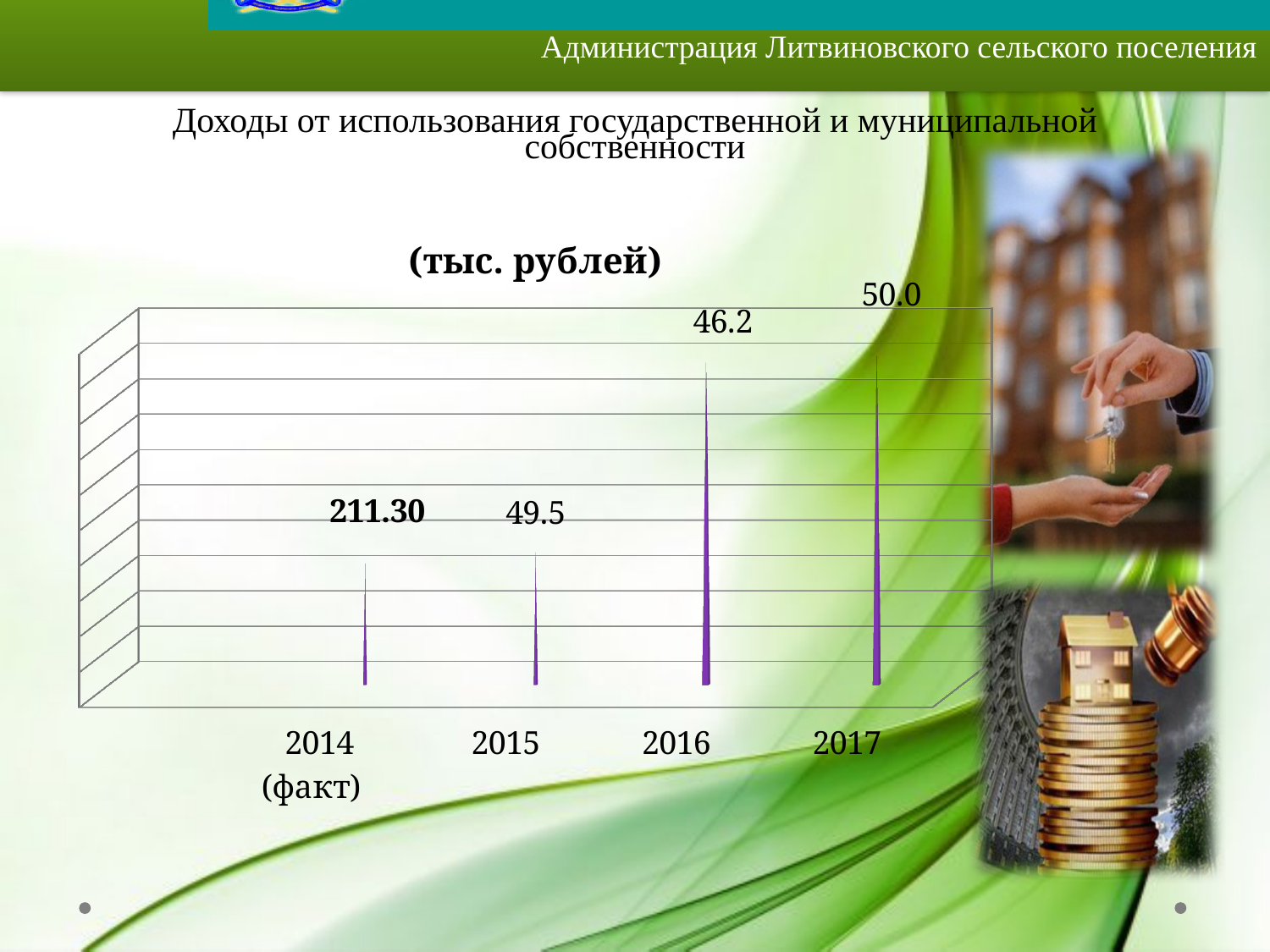
What is the value for 2016? 46.2 What is the title of the slide above the chart? Доходы от использования государственной и муниципальной собственности What is the value for 2015? 49.5 What unit is given in the chart title? тыс. рублей How many years are shown on the x axis of the chart? 4 What kind of chart is shown on the slide? bar chart What is the value for 2017? 50.0 What is the difference between the values for 2017 and 2016? 3.8 Which is larger, the value for 2016 or the value for 2017? 2017 What is the value for 2014 (факт)? 211.30